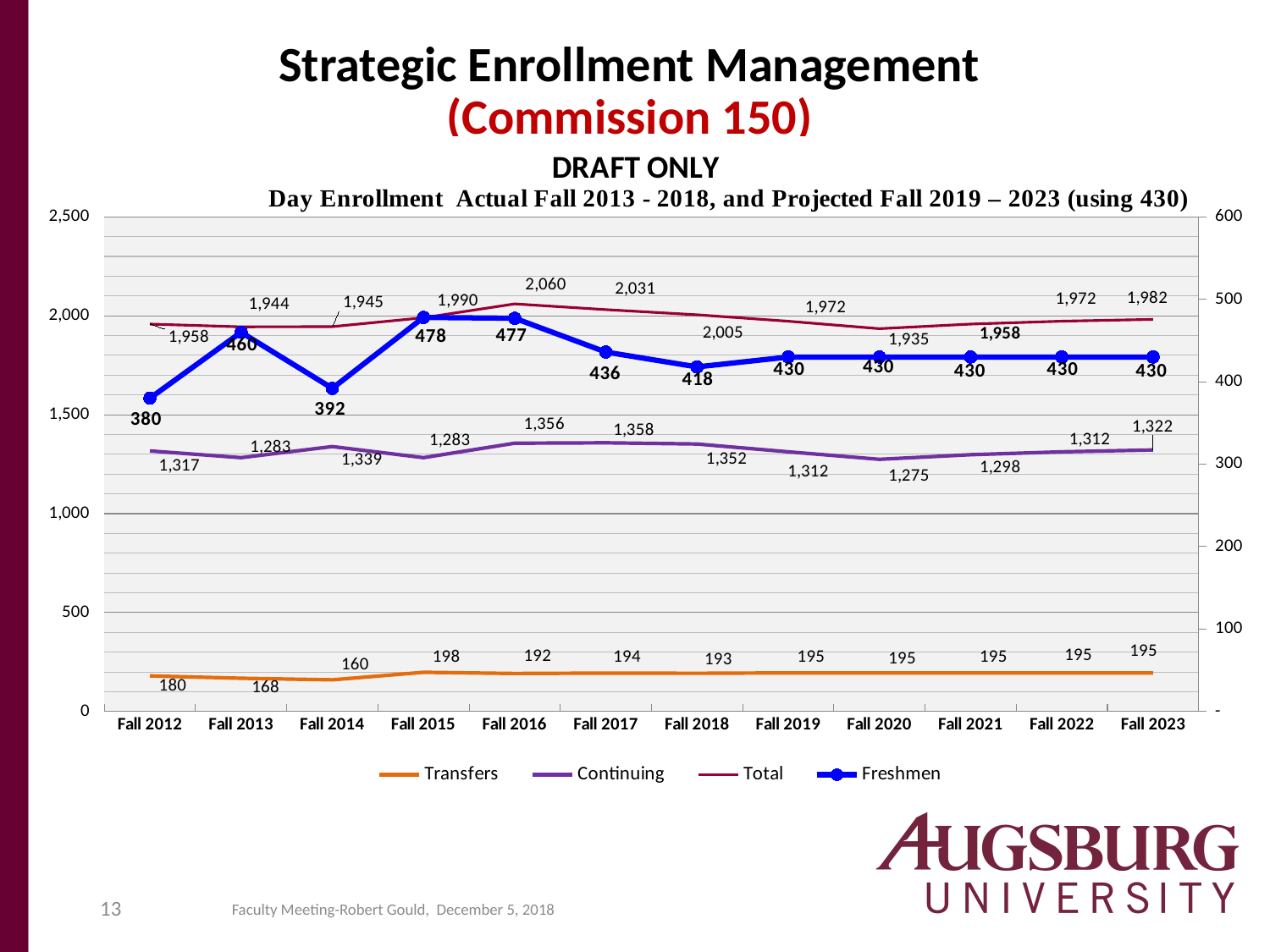
In which year is the Total series highest? Fall 2016 Which is larger, the Continuing value for Fall 2014 or for Fall 2015? Fall 2014 How many series does the legend list? 4 How many years are shown on the x axis? 12 In which year is the Freshmen series highest? Fall 2015 In which year is the Transfers series lowest? Fall 2014 What is the difference between the Total values for Fall 2016 and Fall 2017? 29 What is the Continuing value for Fall 2020? 1,275 What is the Freshmen value for Fall 2012? 380 What colour is the Freshmen line in the legend? Blue What kind of chart is shown on the slide? Line chart Does the Freshmen series rise, fall, or stay flat from Fall 2019 to Fall 2023? Stays flat